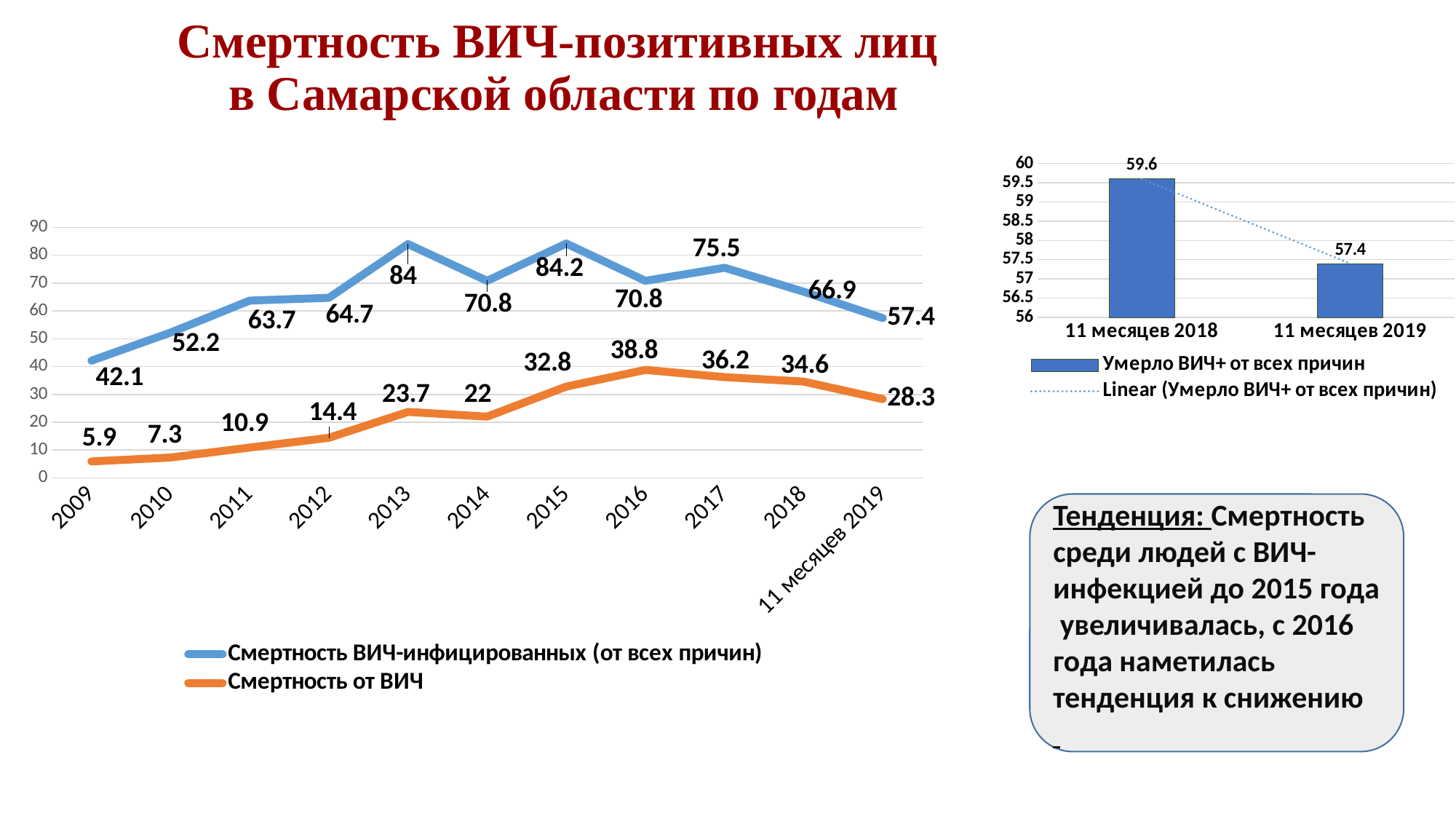
What kind of chart is the chart on the left of the slide? Line chart In the left line chart, what is the difference between the two series in 2009? 36.2 In the left line chart, which year has the highest value for 'Смертность ВИЧ-инфицированных (от всех причин)'? 2015 In the left line chart, is the value of 'Смертность от ВИЧ' higher in 2017 or in 2018? 2017 In the left line chart, what is the value of 'Смертность ВИЧ-инфицированных (от всех причин)' in 2013? 84 In the right chart, what is the difference between '11 месяцев 2018' and '11 месяцев 2019'? 2.2 In the left line chart, which year has the lowest value for 'Смертность от ВИЧ'? 2009 What kind of chart is the chart on the right of the slide? Bar chart In the left line chart, what is the value of 'Смертность от ВИЧ' in 2016? 38.8 How many points along the x axis does the left line chart have? 11 In the right chart, what is the value for '11 месяцев 2019'? 57.4 How many series does the legend of the left line chart list? 2